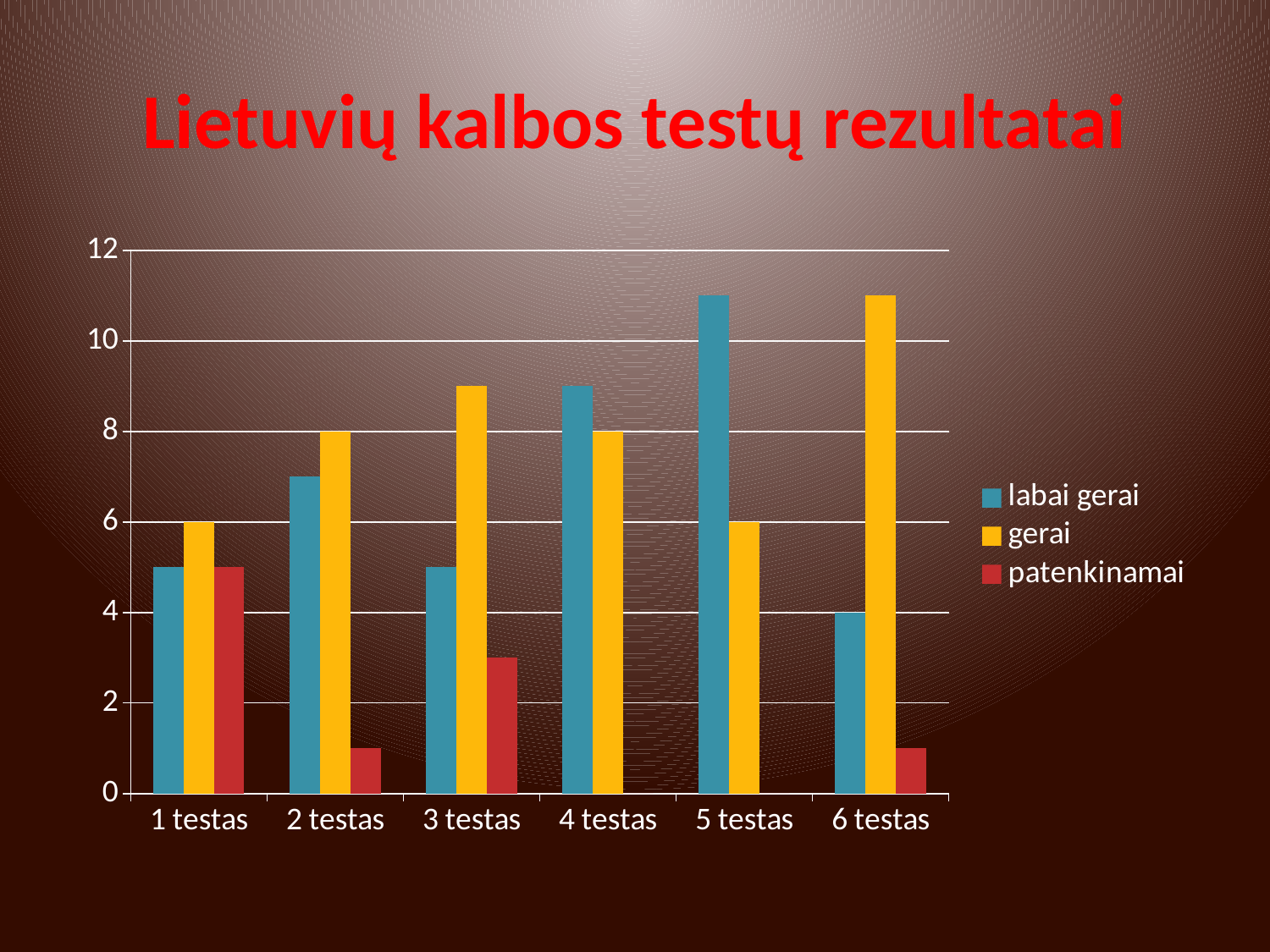
What is the value for 'labai gerai' in 6 testas? 4 In 5 testas, which is larger: 'labai gerai' or 'gerai'? labai gerai How many series does the legend list? 3 What kind of chart is shown on the slide? bar chart What is the value for 'gerai' in 2 testas? 8 How many test categories are shown on the x axis? 6 In which test is the 'gerai' value highest? 6 testas Is the value for 'labai gerai' in 5 testas greater or less than 10? greater In which test is the 'patenkinamai' value highest? 1 testas What is the title of the chart? Lietuvių kalbos testų rezultatai In which test is the 'labai gerai' value highest? 5 testas What is the value for 'gerai' in 5 testas? 6